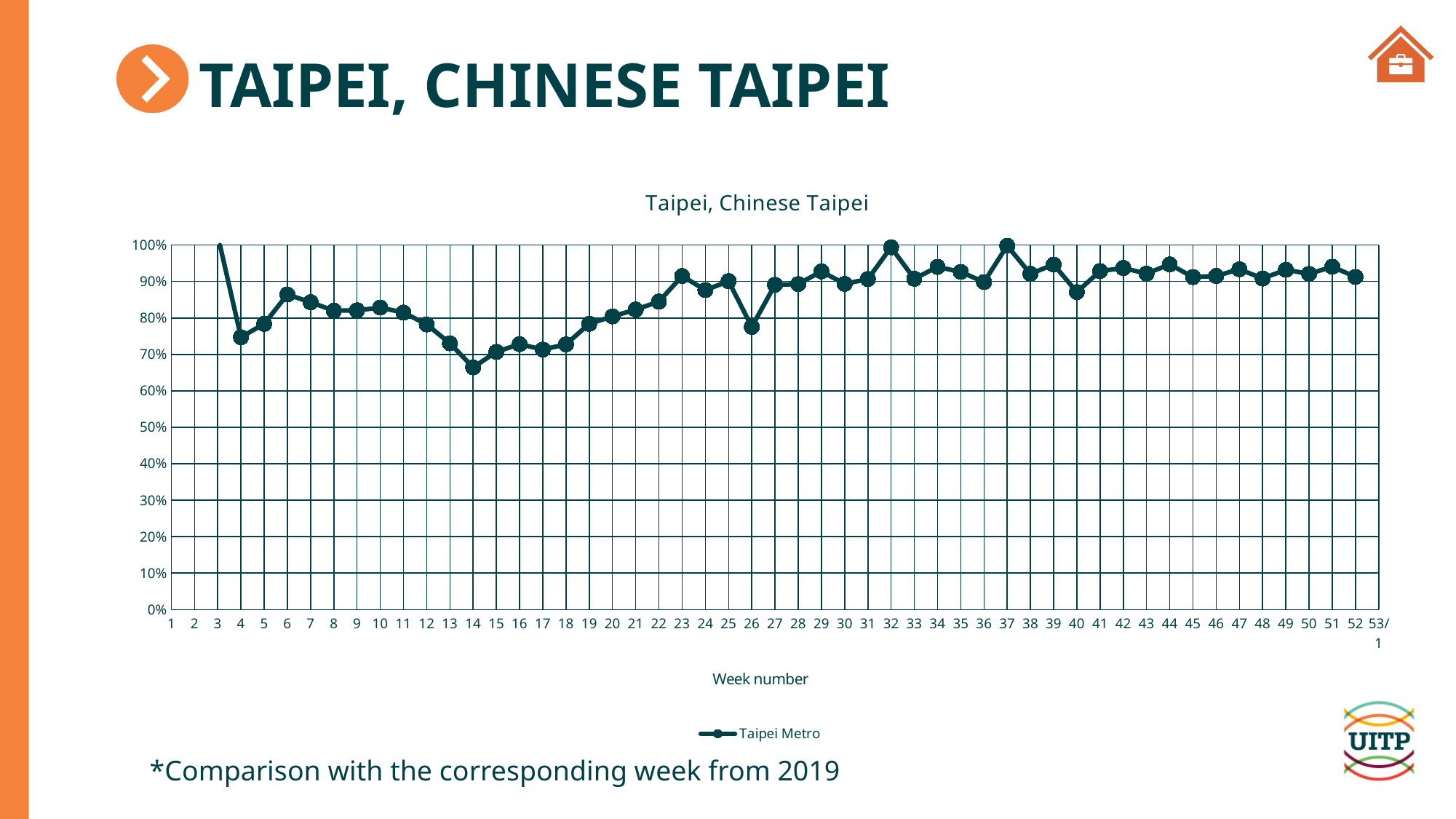
Which week number has the lowest value for Taipei Metro? 14 Do the values rise or fall from week 14 to week 23? rise Is the value for week 4 greater or less than 80%? less What kind of chart is shown on the slide? line chart Which has the larger value, week 4 or week 6? week 6 What is the name of the series shown in the legend? Taipei Metro Which has the larger value, week 14 or week 23? week 23 How many series does the legend list? 1 Is the value for week 14 greater or less than 70%? less Is the value for week 26 greater or less than 80%? less What is the label of the x axis? Week number